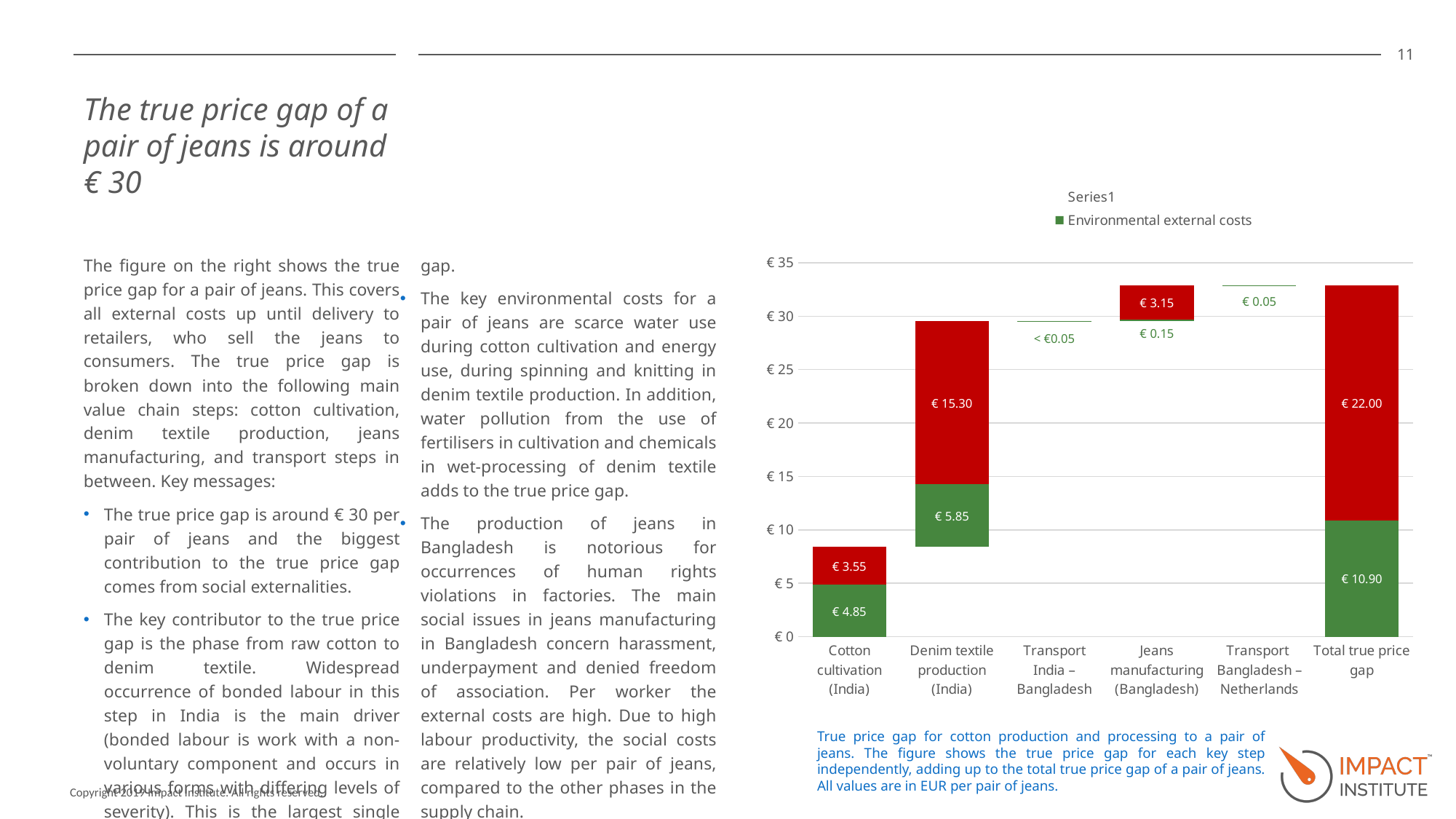
What value is labelled for Transport Bangladesh – Netherlands? € 0.05 What is the value of the red (Series1) segment for Jeans manufacturing (Bangladesh)? € 3.15 What is the difference between the red (Series1) segment and the green environmental segment in the Total true price gap bar? € 11.10 What is the environmental external cost shown for the Total true price gap bar? € 10.90 What is the total height of the Total true price gap bar (sum of its two segments)? € 32.90 Which value chain step (excluding the total) has the largest environmental external cost? Denim textile production (India) What is the value of the red (Series1) segment for Denim textile production (India)? € 15.30 How many series does the chart legend list? 2 What is the environmental external cost for Cotton cultivation (India)? € 4.85 What is the total of the two segments for Denim textile production (India)? € 21.15 Which is larger for Cotton cultivation (India): the environmental external cost or the Series1 segment? Environmental external cost (€ 4.85) How many categories are shown on the x axis of the chart? 6